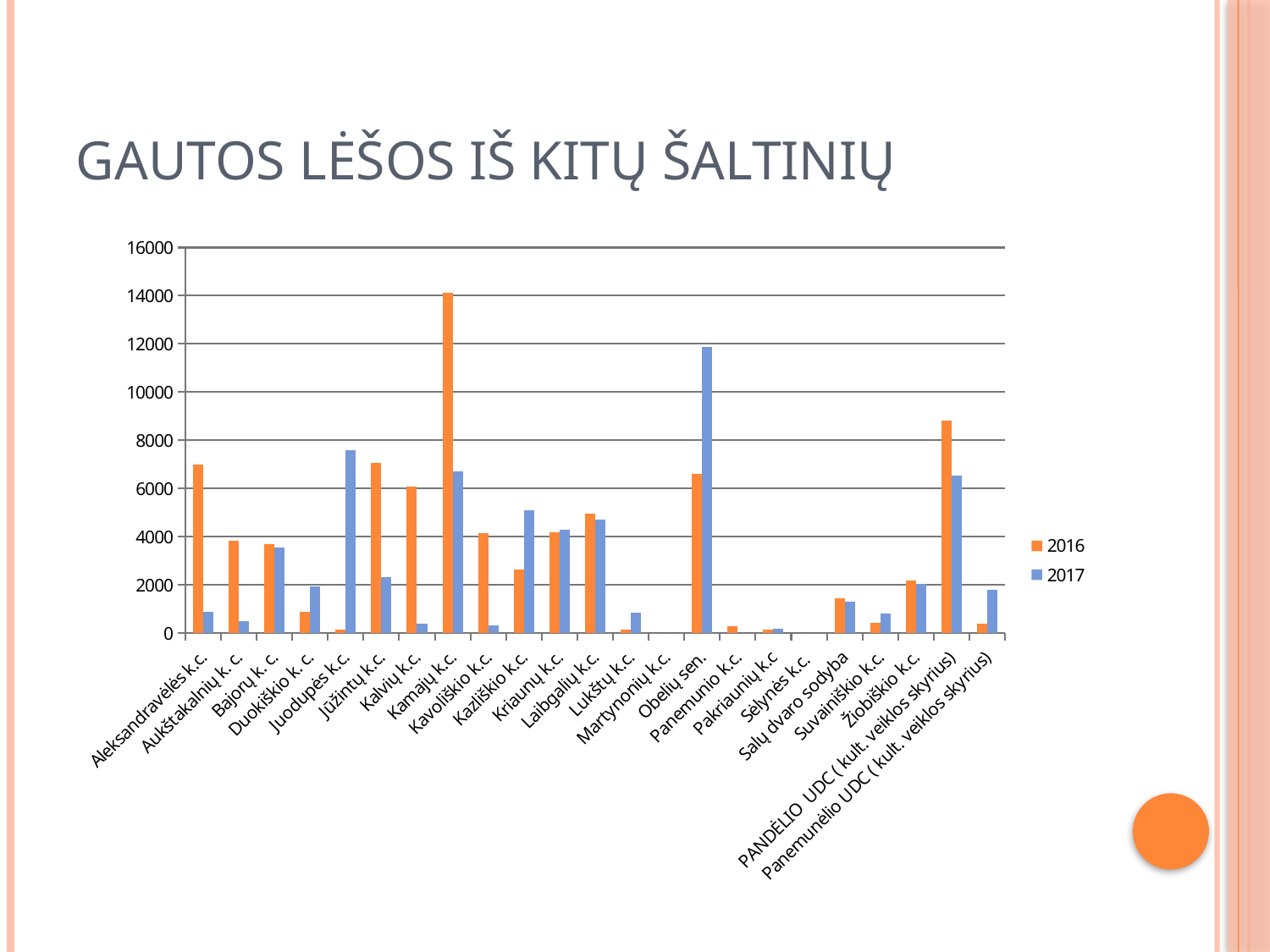
What is the title of the chart? GAUTOS LĖŠOS IŠ KITŲ ŠALTINIŲ How many categories are shown on the x axis? 23 For Aleksandravėlės k.c., which series has the larger value, 2016 or 2017? 2016 Is the 2017 value for Juodupės k.c. greater or less than 6000? greater Which category has the highest value for the 2017 series? Obelių sen. What type of chart is shown on the slide? bar chart How many series does the legend list? 2 Is the 2016 value for Kamajų k.c. greater or less than 12000? greater Is the 2017 value for Obelių sen. greater or less than 10000? greater For Kazliškio k.c., which series has the larger value, 2016 or 2017? 2017 Which category has the highest value for the 2016 series? Kamajų k.c.